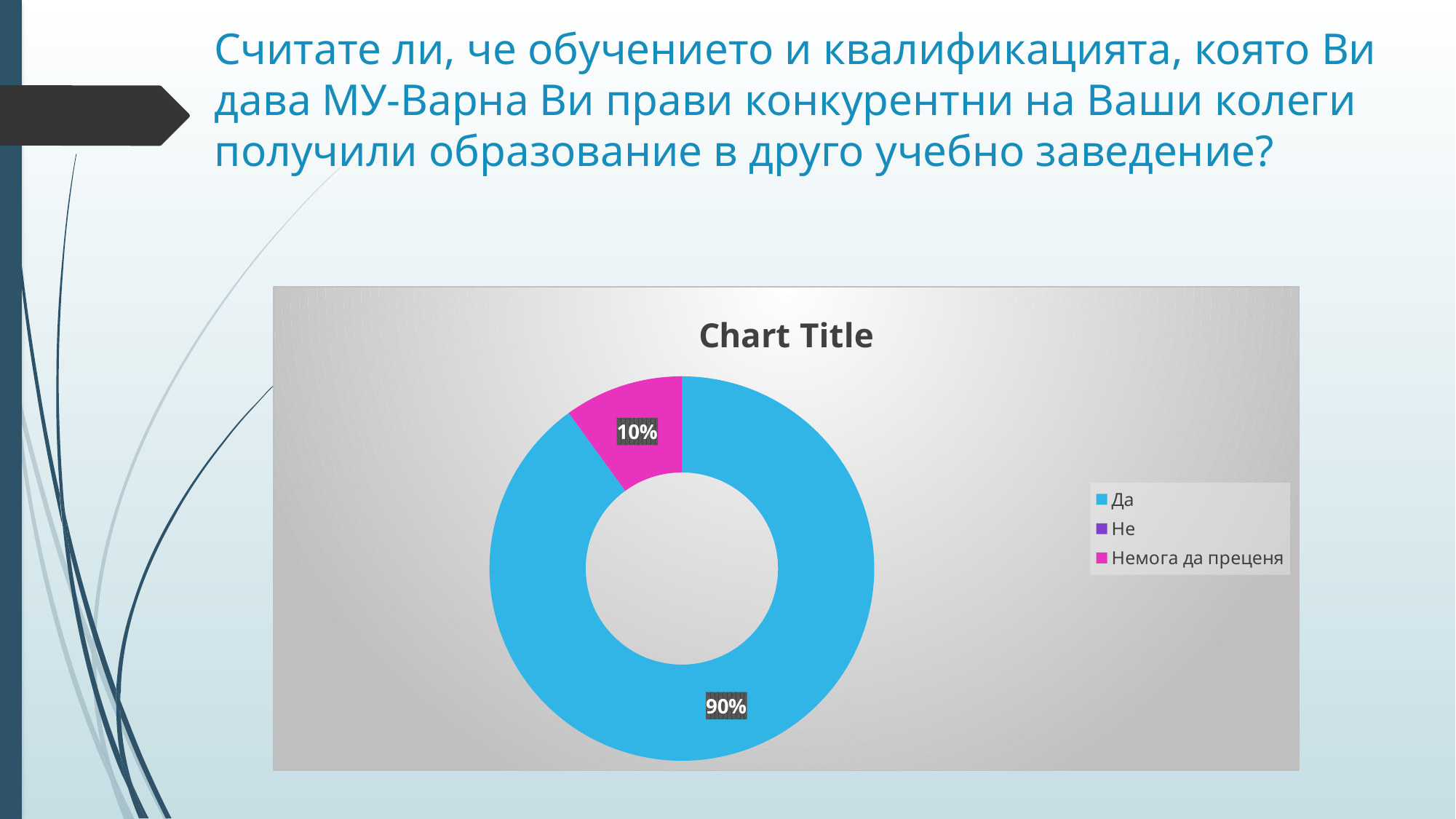
Which is larger, the "Да" slice or the "Немога да преценя" slice? Да How many entries does the legend list? 3 Which category has the largest share of the chart? Да What colour is the "Да" slice? Blue What percentage is shown for the "Да" slice? 90% Is the value for "Да" greater or less than 50%? greater What is the title shown on the chart? Chart Title Which of the visible slices is the smallest? Немога да преценя What kind of chart is shown on the slide? Doughnut chart What percentage is shown for the "Немога да преценя" slice? 10% What is the difference in percentage points between the "Да" and "Немога да преценя" slices? 80